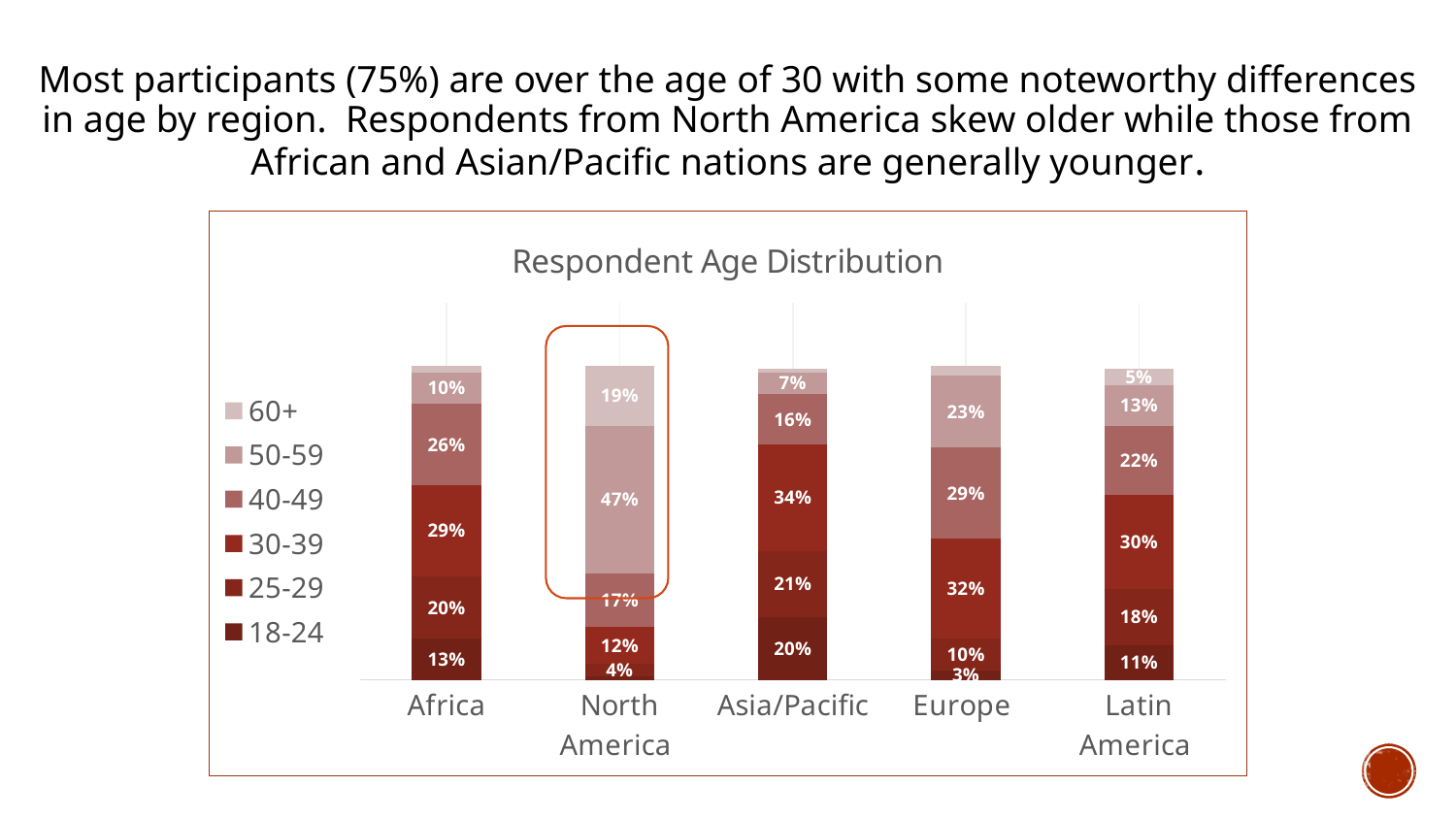
What kind of chart is shown on the slide? Stacked bar chart How many regions are shown along the x axis of the chart? 5 What percentage of Asia/Pacific respondents are aged 25-29? 21% Which region has a larger share of respondents aged 50-59, Europe or Latin America? Europe What percentage of Latin America respondents are aged 60+? 5% Which region has the lowest share of respondents aged 18-24? North America What is the title of the chart? Respondent Age Distribution Which region has the highest share of respondents aged 40-49? Europe What percentage of North America respondents are aged 40-49? 17% What percentage of Europe respondents are aged 18-24? 3% How many percentage points higher is the 30-39 share for Asia/Pacific than for Africa? 5 percentage points How many age groups does the legend of the Respondent Age Distribution chart list? 6